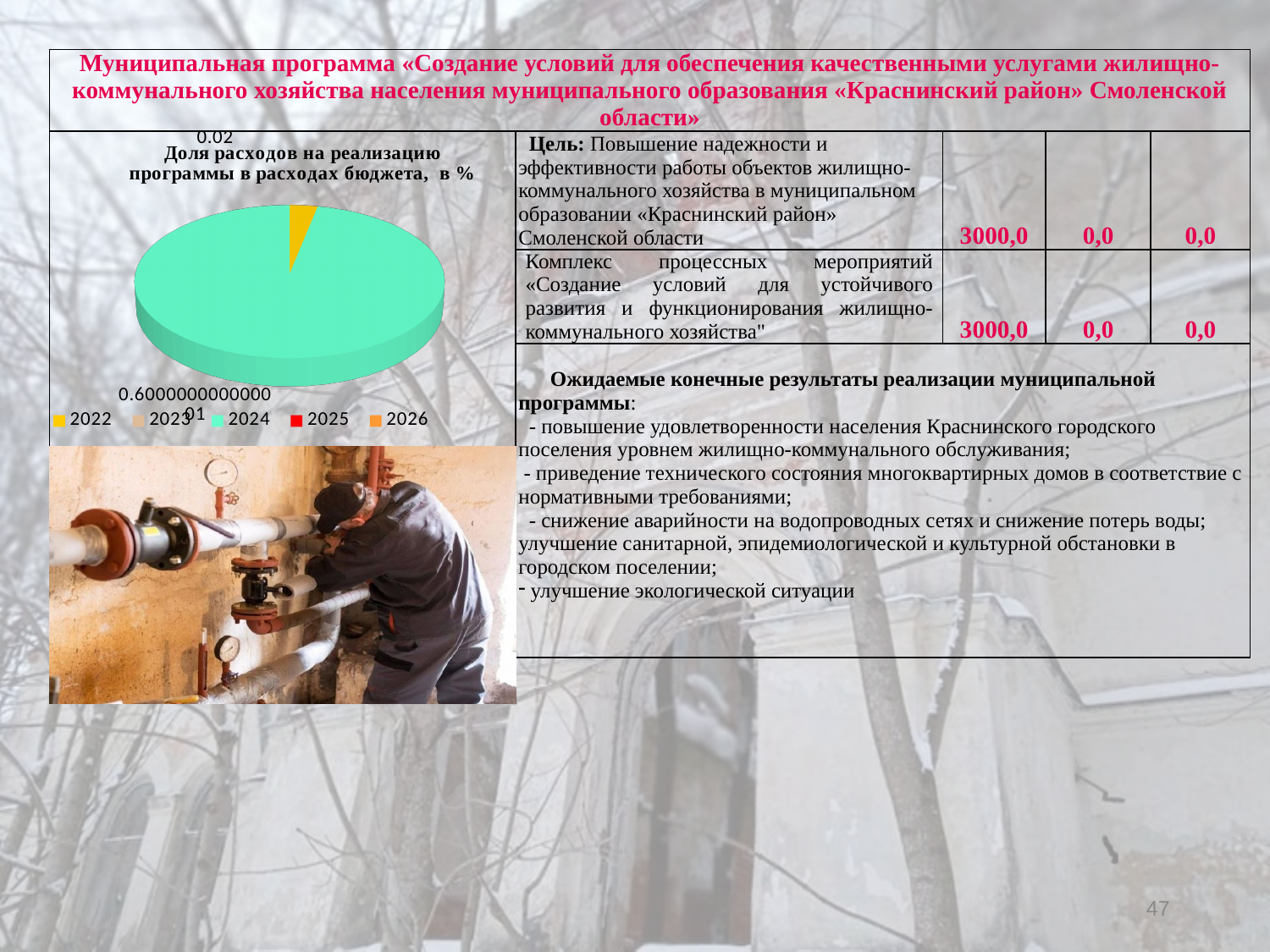
Which year has the largest slice in the pie chart? 2024 Which year is represented by the small yellow slice in the pie chart? 2022 How many entries does the legend of the pie chart list? 5 Which slice is larger in the pie chart, 2022 or 2024? 2024 What is the title of the pie chart? Доля расходов на реализацию программы в расходах бюджета, в % What colour is the 2024 slice in the pie chart? teal (light green) What is the data label shown for the 2022 slice of the pie chart? 0.02 Which legend entries of the pie chart are listed after 2024? 2025 and 2026 What kind of chart is shown on the slide? pie chart